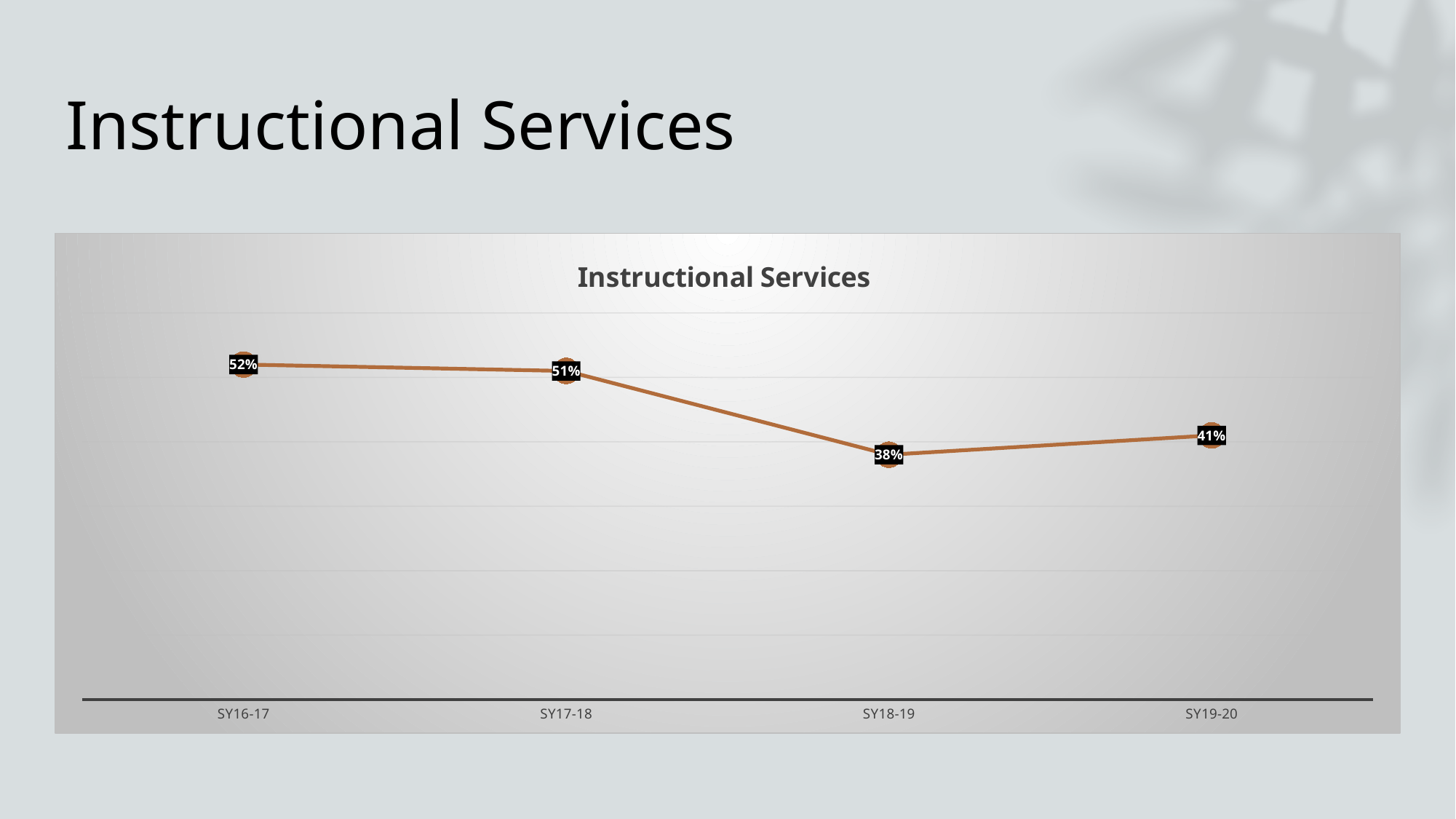
What is the value for SY18-19? 38% Which school year has the lowest value? SY18-19 Which is larger, the value for SY17-18 or the value for SY19-20? SY17-18 What is the title of the chart? Instructional Services What is the difference between the values for SY19-20 and SY18-19? 3% What is the value for SY17-18? 51% Which school year has the highest value? SY16-17 What kind of chart is shown? Line chart What is the value for SY16-17? 52% How many school years are plotted on the chart? 4 What is the difference between the values for SY16-17 and SY18-19? 14% What is the value for SY19-20? 41%